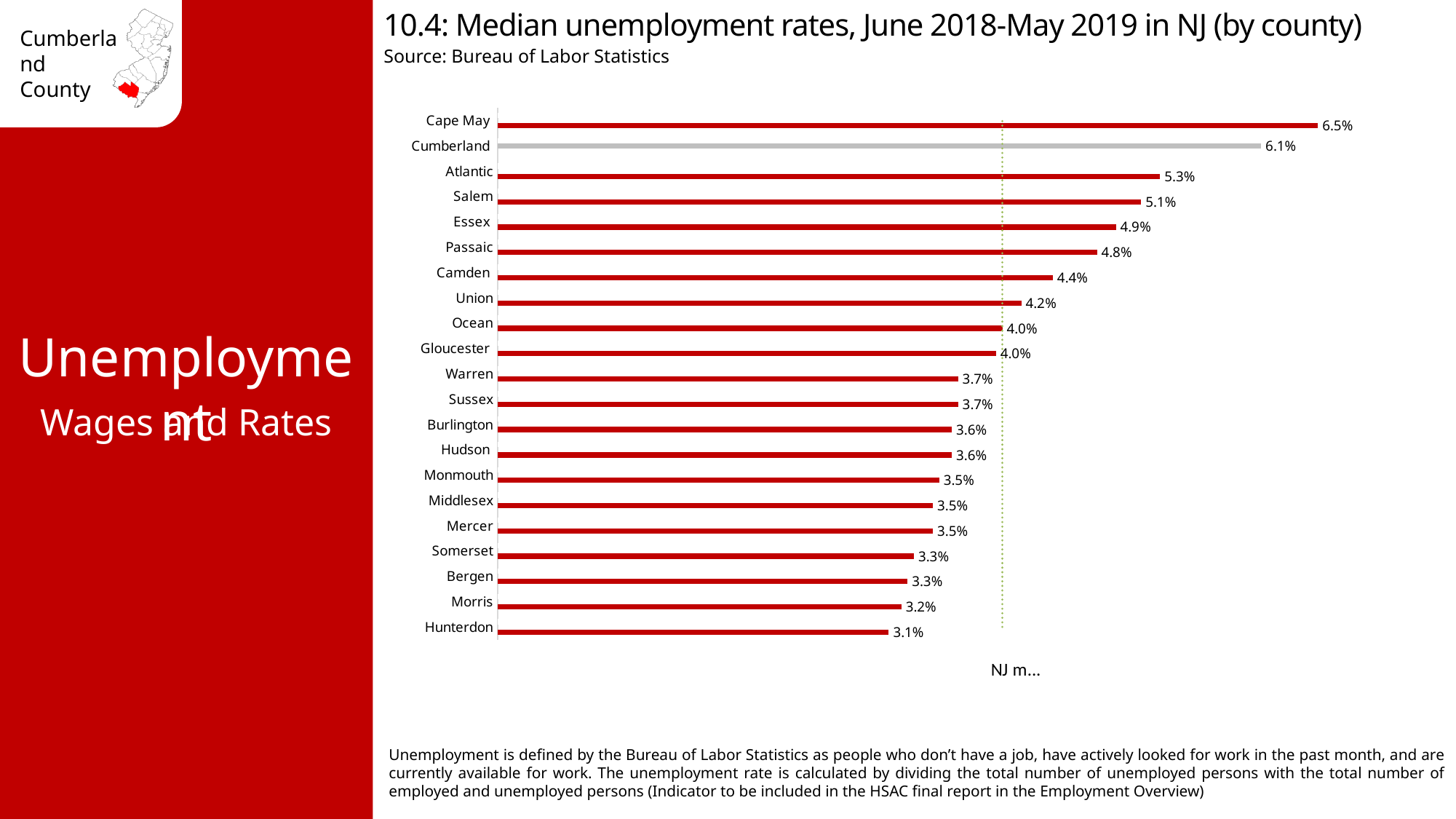
What is the median unemployment rate for Camden County? 4.4% What is the difference between the median unemployment rates of Cape May and Cumberland? 0.4% What is the median unemployment rate for Hunterdon County? 3.1% Which county has a higher median unemployment rate, Union or Morris? Union Which county's bar is shown in grey rather than red? Cumberland Which county has a higher median unemployment rate, Salem or Passaic? Salem What is the difference between the median unemployment rates of Atlantic and Hunterdon? 2.2% What is the median unemployment rate for Cumberland County? 6.1% What kind of chart is used on this slide? Bar chart Which county has the lowest median unemployment rate? Hunterdon Which county has the highest median unemployment rate? Cape May How many counties are shown in the chart? 21